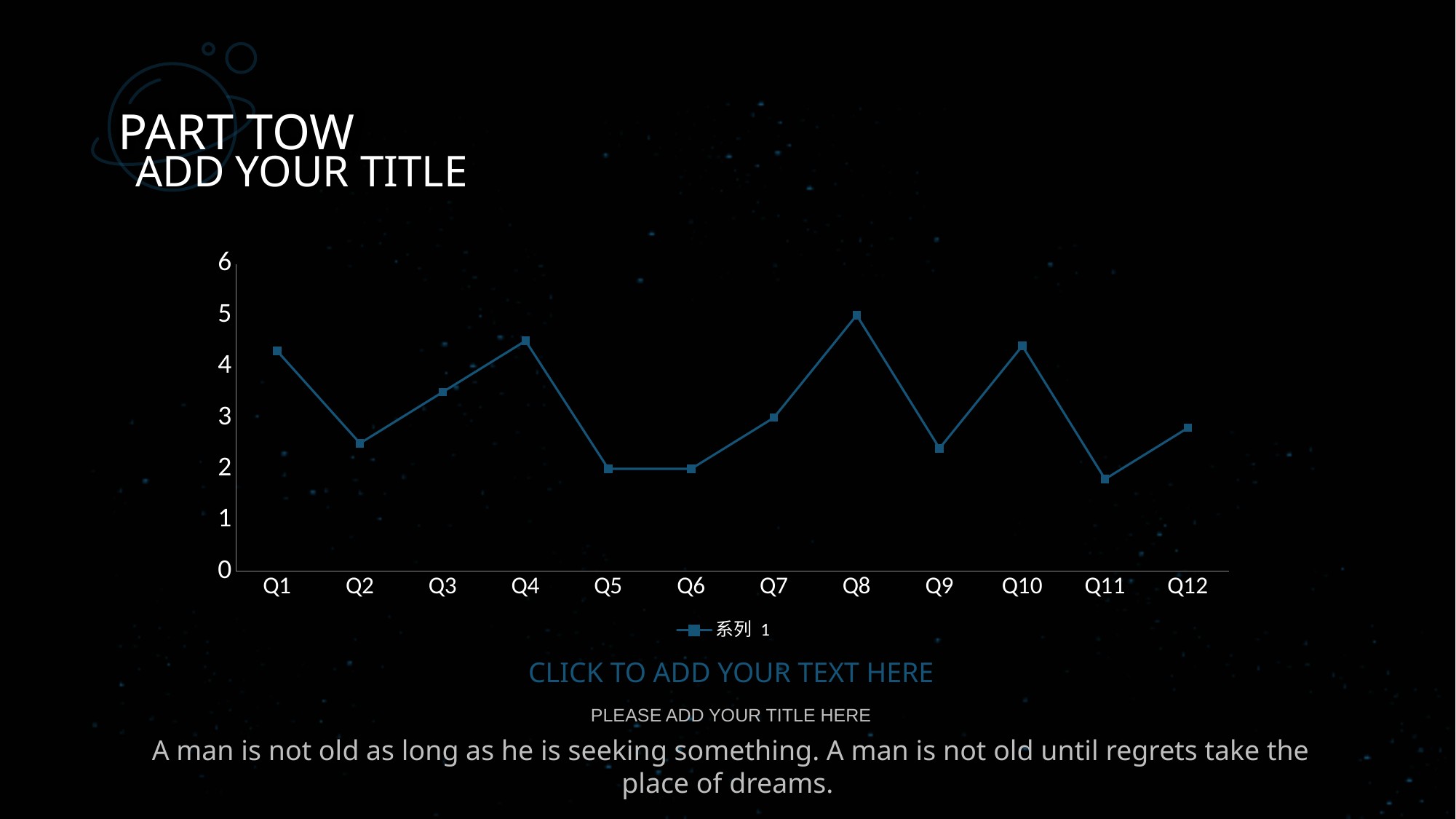
What kind of chart is shown on the slide? line chart Do the values rise or fall from Q5 to Q8? rise Is the value for Q1 greater or less than 4? greater Which is larger, the value for Q4 or the value for Q2? Q4 Which category has the lowest value? Q11 What is the value for Q7? 3 Is the value for Q11 greater or less than 2? less Which category has the highest value? Q8 What is the value for Q5? 2 What is the value for Q8? 5 How many series does the legend list? 1 How many categories are plotted along the x axis? 12